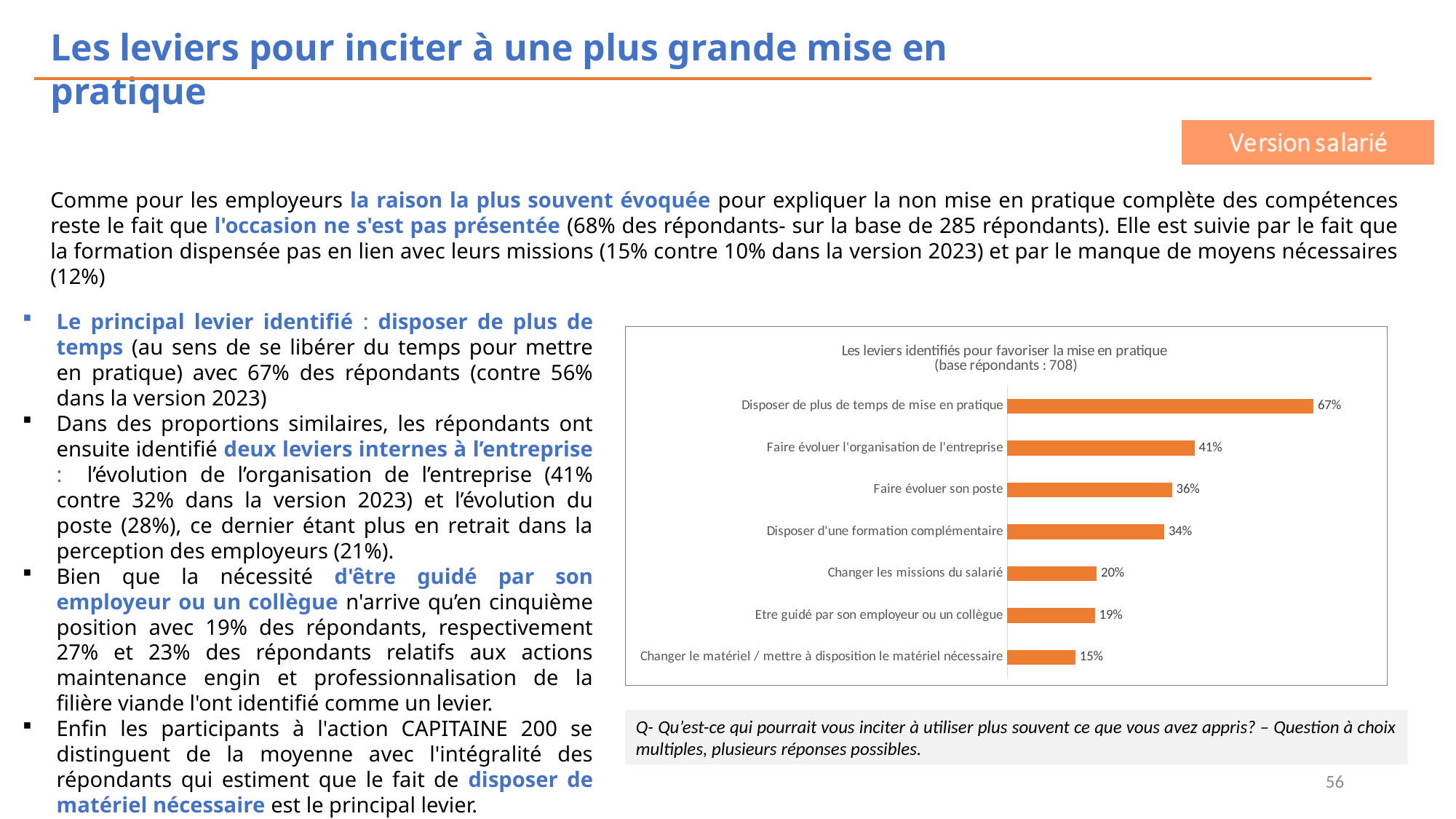
Which is larger: "Faire évoluer son poste" or "Disposer d'une formation complémentaire"? Faire évoluer son poste What kind of chart is shown? Bar chart What is the value for "Changer les missions du salarié"? 20% Which category has the lowest value? Changer le matériel / mettre à disposition le matériel nécessaire What is the value for "Disposer de plus de temps de mise en pratique"? 67% Which category has the highest value? Disposer de plus de temps de mise en pratique What is the difference between "Disposer de plus de temps de mise en pratique" and "Faire évoluer l'organisation de l'entreprise"? 26% How many categories are shown in the chart? 7 What is the title of the chart? Les leviers identifiés pour favoriser la mise en pratique (base répondants : 708) What colour are the bars in the chart? Orange What is the value for "Faire évoluer l'organisation de l'entreprise"? 41% What is the value for "Etre guidé par son employeur ou un collègue"? 19%